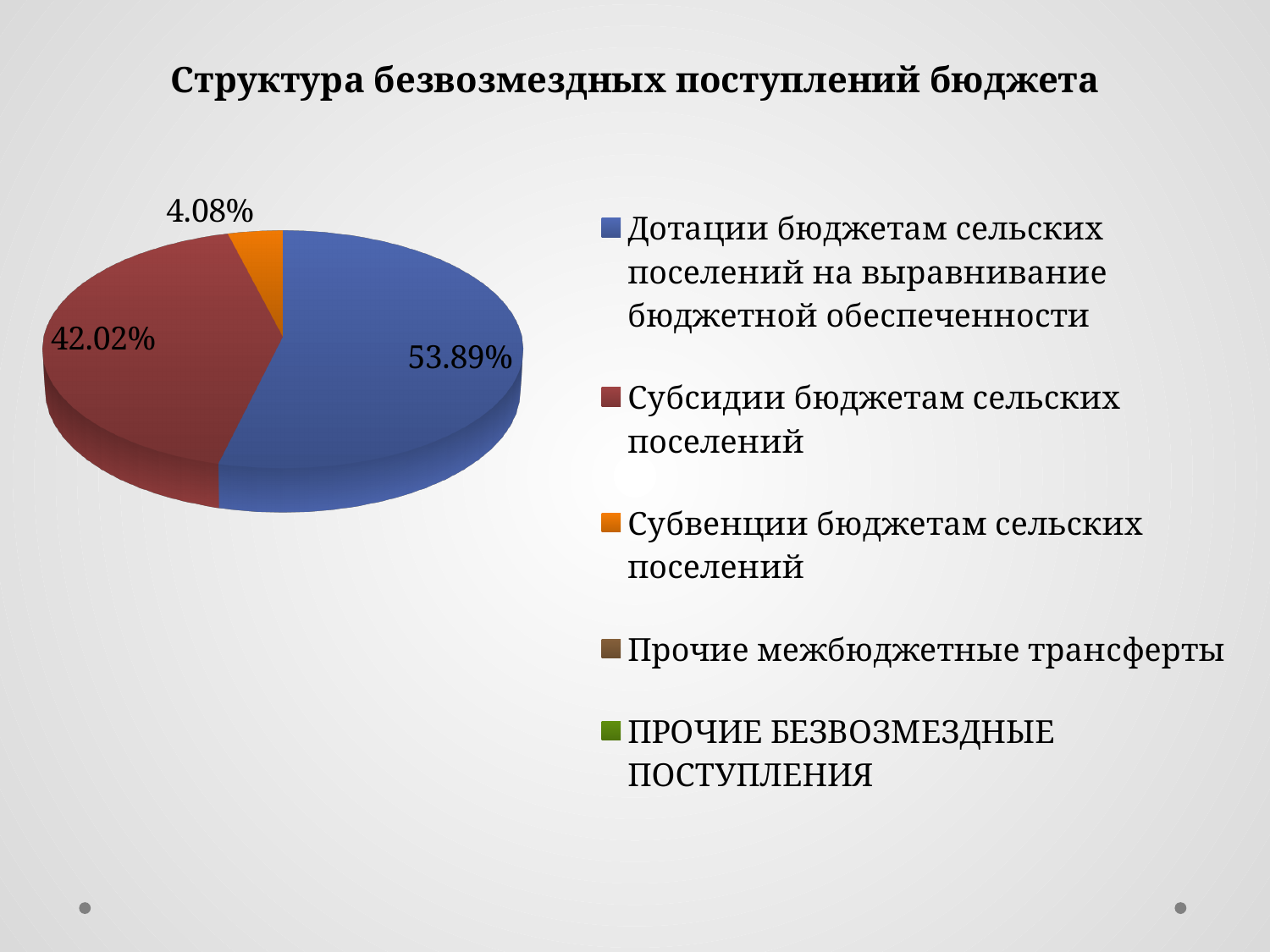
What share of the pie is labelled for "Субвенции бюджетам сельских поселений"? 4.08% What share of the pie is labelled for "Субсидии бюджетам сельских поселений"? 42.02% What share of the pie is labelled for "Дотации бюджетам сельских поселений на выравнивание бюджетной обеспеченности"? 53.89% How many slices with data labels are visible in the pie? 3 What is the title of the chart? Структура безвозмездных поступлений бюджета What colour is the slice for "Субвенции бюджетам сельских поселений"? Orange What is the difference in percentage points between the "Дотации" slice and the "Субсидии" slice? 11.87 Which is larger: the "Субсидии бюджетам сельских поселений" slice or the "Субвенции бюджетам сельских поселений" slice? Субсидии бюджетам сельских поселений What type of chart is shown on the slide? Pie chart Which category has the largest slice of the pie? Дотации бюджетам сельских поселений на выравнивание бюджетной обеспеченности Which labelled slice of the pie is the smallest? Субвенции бюджетам сельских поселений How many entries does the legend list? 5